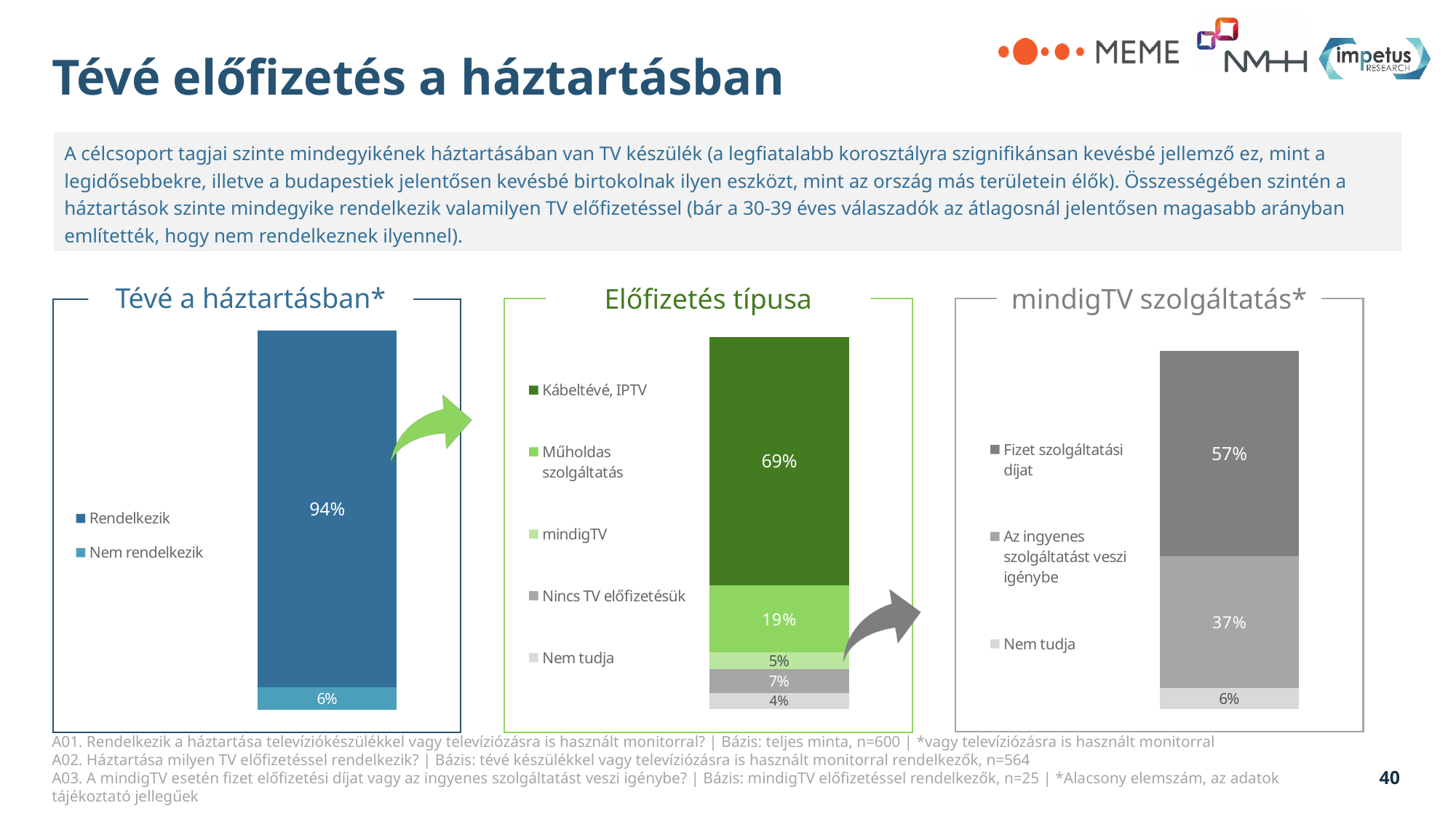
In the 'Előfizetés típusa' chart, how many segments does the legend list? 5 In the 'Előfizetés típusa' chart, which is larger: 'mindigTV' or 'Nincs TV előfizetésük'? Nincs TV előfizetésük In the 'Tévé a háztartásban*' chart, what is the value for 'Rendelkezik'? 94% In the 'mindigTV szolgáltatás*' chart, what is the value for 'Az ingyenes szolgáltatást veszi igénybe'? 37% In the 'Előfizetés típusa' chart, what is the value for 'Kábeltévé, IPTV'? 69% In the 'mindigTV szolgáltatás*' chart, what is the difference between 'Fizet szolgáltatási díjat' and 'Az ingyenes szolgáltatást veszi igénybe'? 20% In the 'Előfizetés típusa' chart, what is the value for 'Műholdas szolgáltatás'? 19% In the 'mindigTV szolgáltatás*' chart, what is the value for 'Fizet szolgáltatási díjat'? 57% What type of chart is the 'mindigTV szolgáltatás*' chart? Stacked bar chart In the 'Előfizetés típusa' chart, which segment has the lowest value? Nem tudja In the 'Tévé a háztartásban*' chart, what is the difference between 'Rendelkezik' and 'Nem rendelkezik'? 88% In the 'Tévé a háztartásban*' chart, what is the value for 'Nem rendelkezik'? 6%